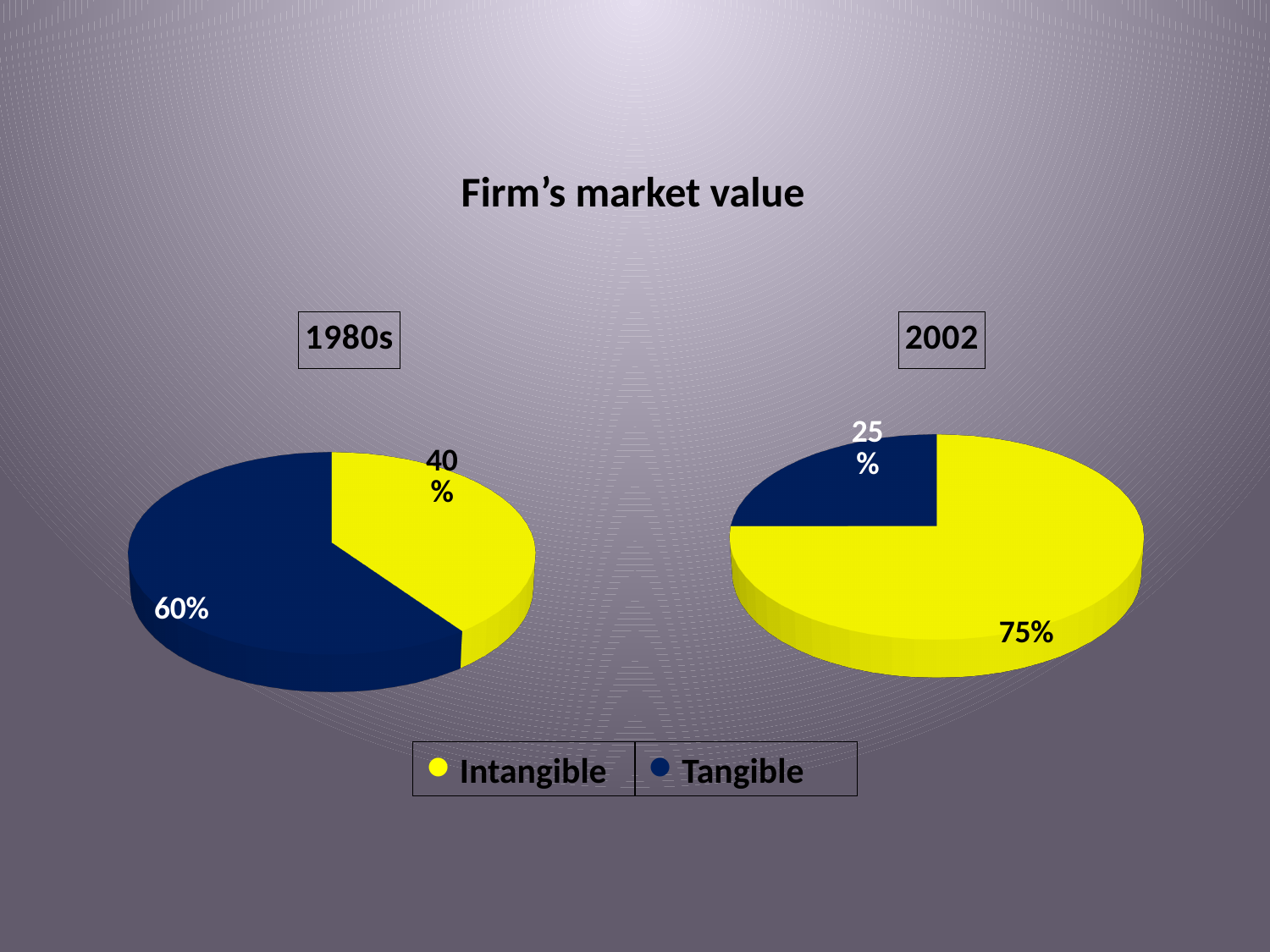
What kind of chart is used on this slide? Pie chart How many series does the legend list? 2 In the 1980s pie chart, what share of the firm's market value is Tangible? 60% In the 2002 pie chart, what share of the firm's market value is Intangible? 75% In the 1980s pie chart, what is the difference between the Tangible and Intangible shares? 20% In the 1980s pie chart, what share of the firm's market value is Intangible? 40% In the 2002 pie chart, what is the difference between the Intangible and Tangible shares? 50% In the 2002 pie chart, what share of the firm's market value is Tangible? 25% In the 2002 pie chart, which category has the smaller share? Tangible In the 1980s pie chart, which category has the larger share? Tangible What is the title shown above the charts? Firm's market value Is the Intangible share larger in the 1980s pie chart or in the 2002 pie chart? 2002